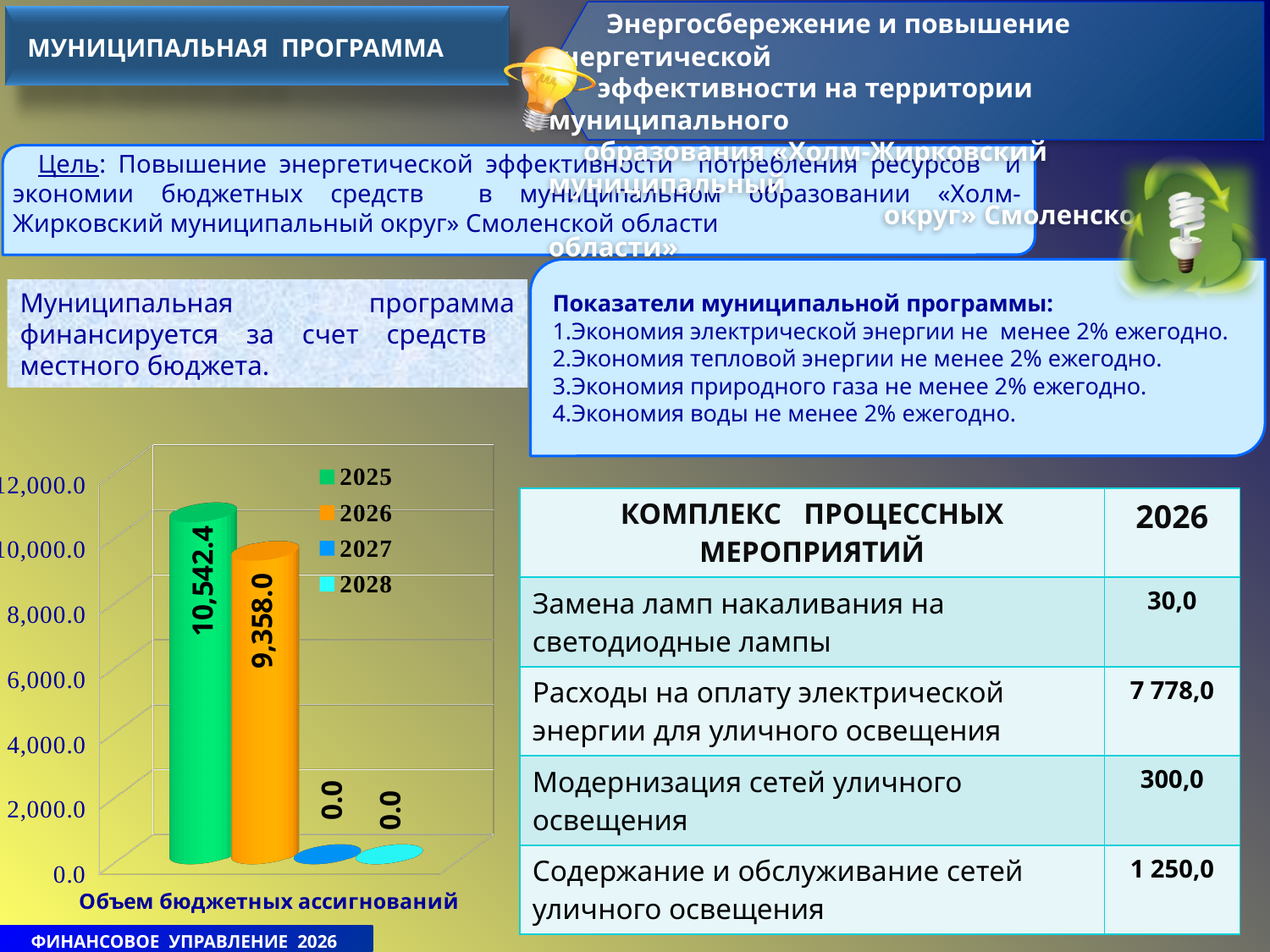
Is the value for 2025 in the chart greater or less than 10,000.0? greater Which year has the highest value in the chart? 2025 What is the value for 2026 in the chart? 9,358.0 What is the difference between the values for 2025 and 2026 in the chart? 1,184.4 What is the value for 2025 in the chart? 10,542.4 How many series does the chart legend list? 4 What is the value for 2028 in the chart? 0.0 Is the value for 2026 in the chart greater or less than 10,000.0? less What is the value for 2027 in the chart? 0.0 What is the label printed below the chart? Объем бюджетных ассигнований Which is larger in the chart, the value for 2025 or the value for 2026? 2025 What kind of chart is shown on the slide? bar chart